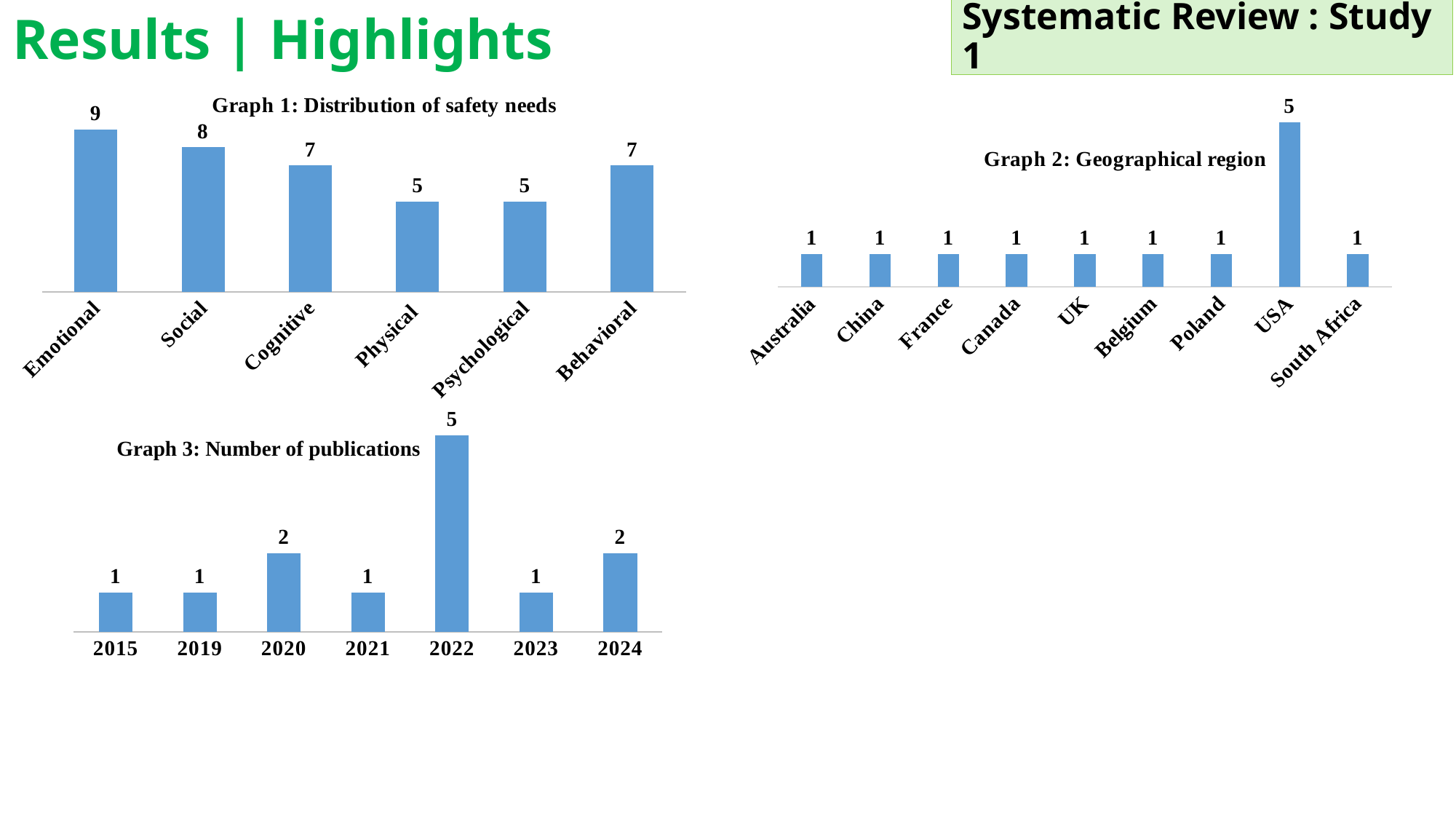
In Graph 1: Distribution of safety needs, how many categories are shown? 6 In Graph 2: Geographical region, which region has the highest value? USA In Graph 2: Geographical region, which is larger, the value for USA or the value for Poland? USA In Graph 3: Number of publications, which year has the highest value? 2022 In Graph 1: Distribution of safety needs, what is the difference between the values for Emotional and Physical? 4 In Graph 3: Number of publications, what is the difference between the values for 2022 and 2024? 3 In Graph 1: Distribution of safety needs, what is the value for Social? 8 What kind of chart is Graph 3: Number of publications? Bar chart In Graph 1: Distribution of safety needs, which category has the highest value? Emotional In Graph 2: Geographical region, how many regions are shown? 9 In Graph 3: Number of publications, what is the value for 2022? 5 In Graph 2: Geographical region, what is the value for USA? 5